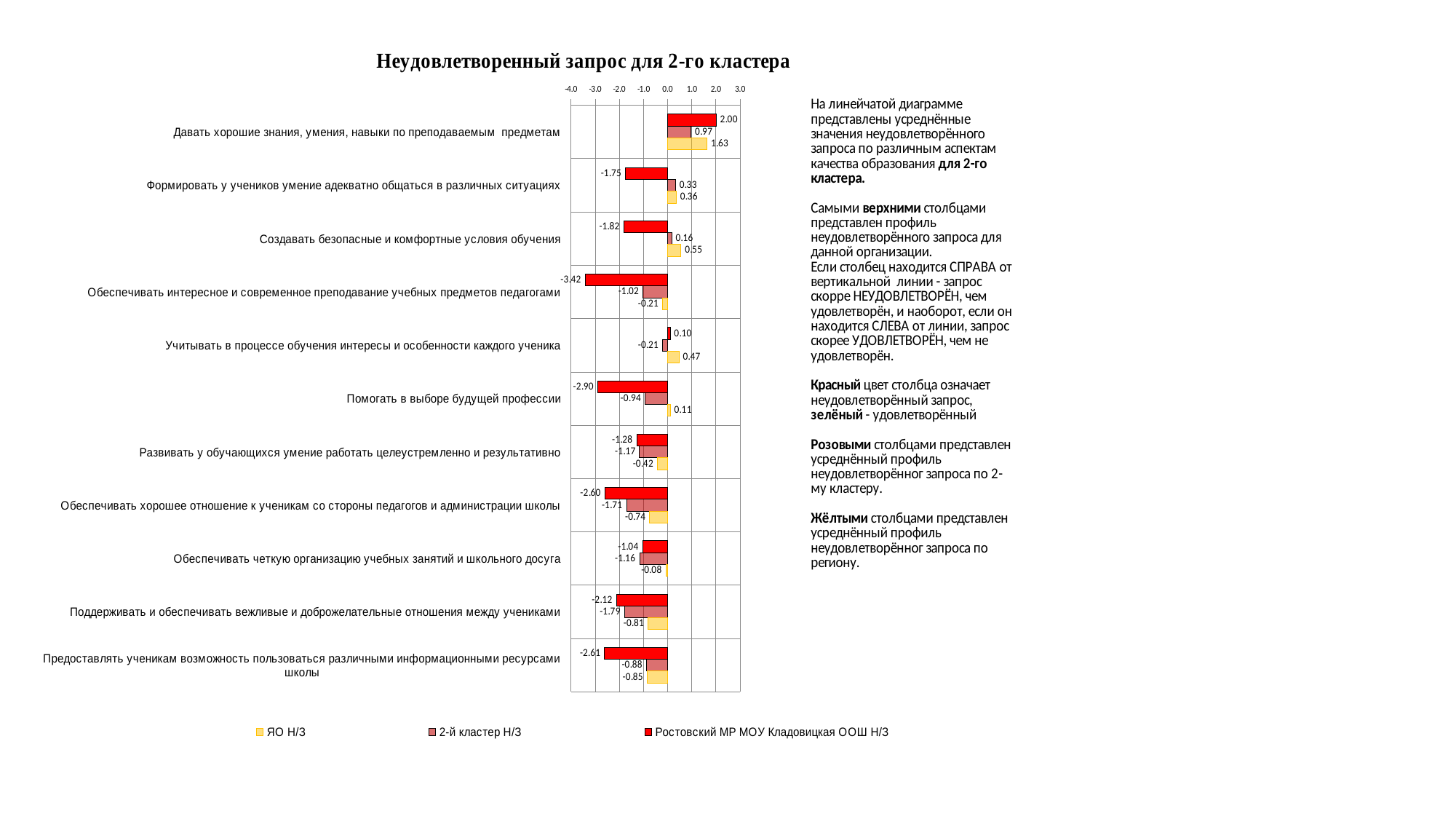
For which category is the Ростовский МР МОУ Кладовицкая ООШ Н/З value the lowest? Обеспечивать интересное и современное преподавание учебных предметов педагогами Which is larger for "Обеспечивать четкую организацию учебных занятий и школьного досуга": the Ростовский МР МОУ Кладовицкая ООШ Н/З value or the 2-й кластер Н/З value? Ростовский МР МОУ Кладовицкая ООШ Н/З How many categories are shown on the chart? 11 What is the title of the chart? Неудовлетворенный запрос для 2-го кластера What is the value of the Ростовский МР МОУ Кладовицкая ООШ Н/З series for "Давать хорошие знания, умения, навыки по преподаваемым предметам"? 2.00 What is the value of the Ростовский МР МОУ Кладовицкая ООШ Н/З series for "Обеспечивать интересное и современное преподавание учебных предметов педагогами"? -3.42 How many series does the legend list? 3 What is the value of the ЯО Н/З series for "Создавать безопасные и комфортные условия обучения"? 0.55 What kind of chart is shown on the slide? Bar chart What is the difference between the ЯО Н/З value and the 2-й кластер Н/З value for "Давать хорошие знания, умения, навыки по преподаваемым предметам"? 0.66 For which category is the ЯО Н/З value the highest? Давать хорошие знания, умения, навыки по преподаваемым предметам What is the value of the 2-й кластер Н/З series for "Помогать в выборе будущей профессии"? -0.94